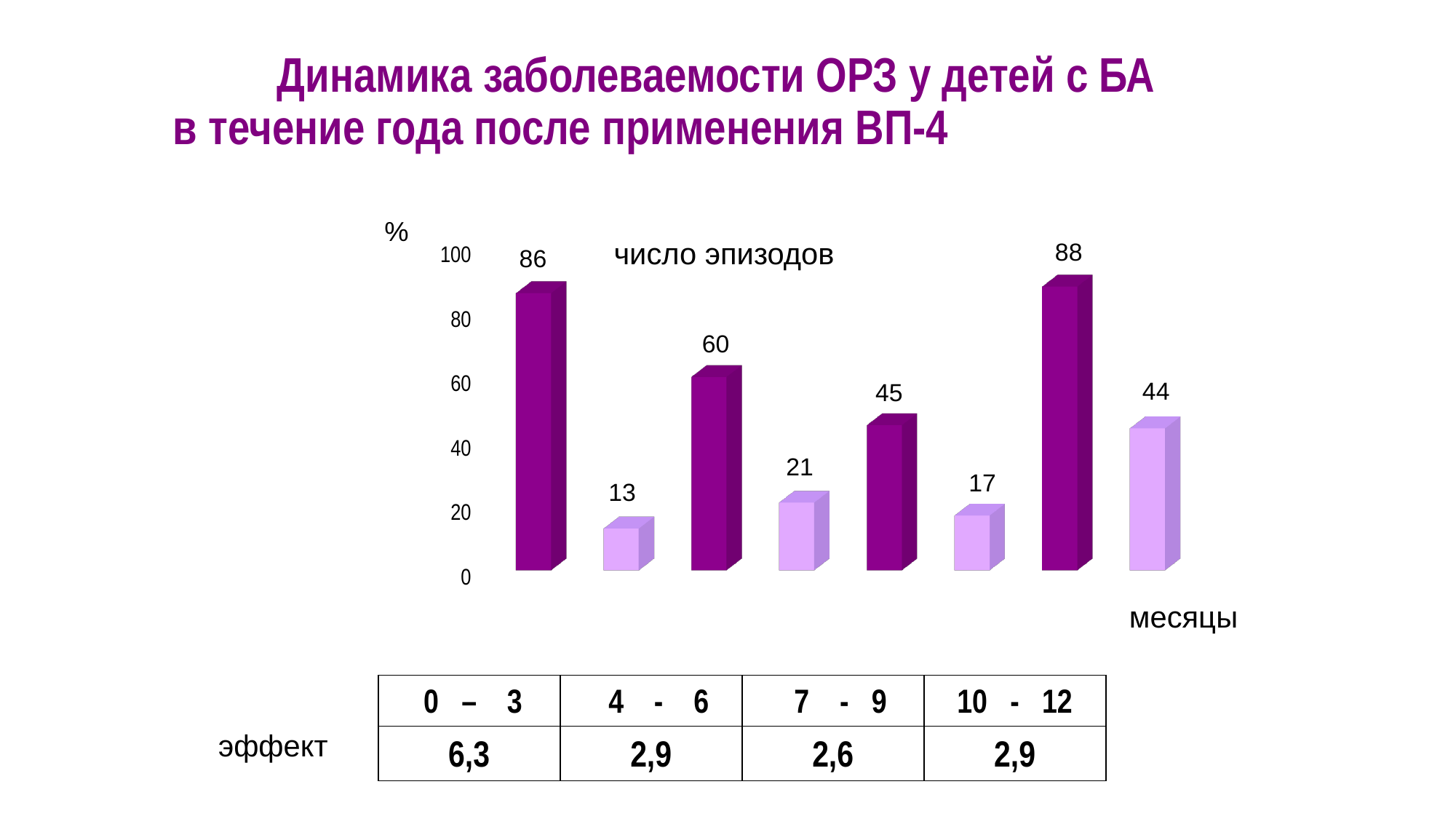
What is the label printed at the top of the chart's vertical axis? % Which is larger: the light purple bar for 4–6 months or the light purple bar for 7–9 months? 4 - 6 How many month periods are shown on the x axis of the chart? 4 What is the value of the dark purple bar for the 4–6 months period? 60 What is the title printed inside the chart area? число эпизодов Which period has the lowest light purple bar? 0 – 3 Which period has the highest dark purple bar? 10 - 12 What type of chart is shown on the slide? bar chart What is the value of the dark purple bar for the 0–3 months period? 86 What is the difference between the dark purple and light purple bars for the 7–9 months period? 24 What is the value of the light purple bar for the 10–12 months period? 44 What is the value of the light purple bar for the 0–3 months period? 13